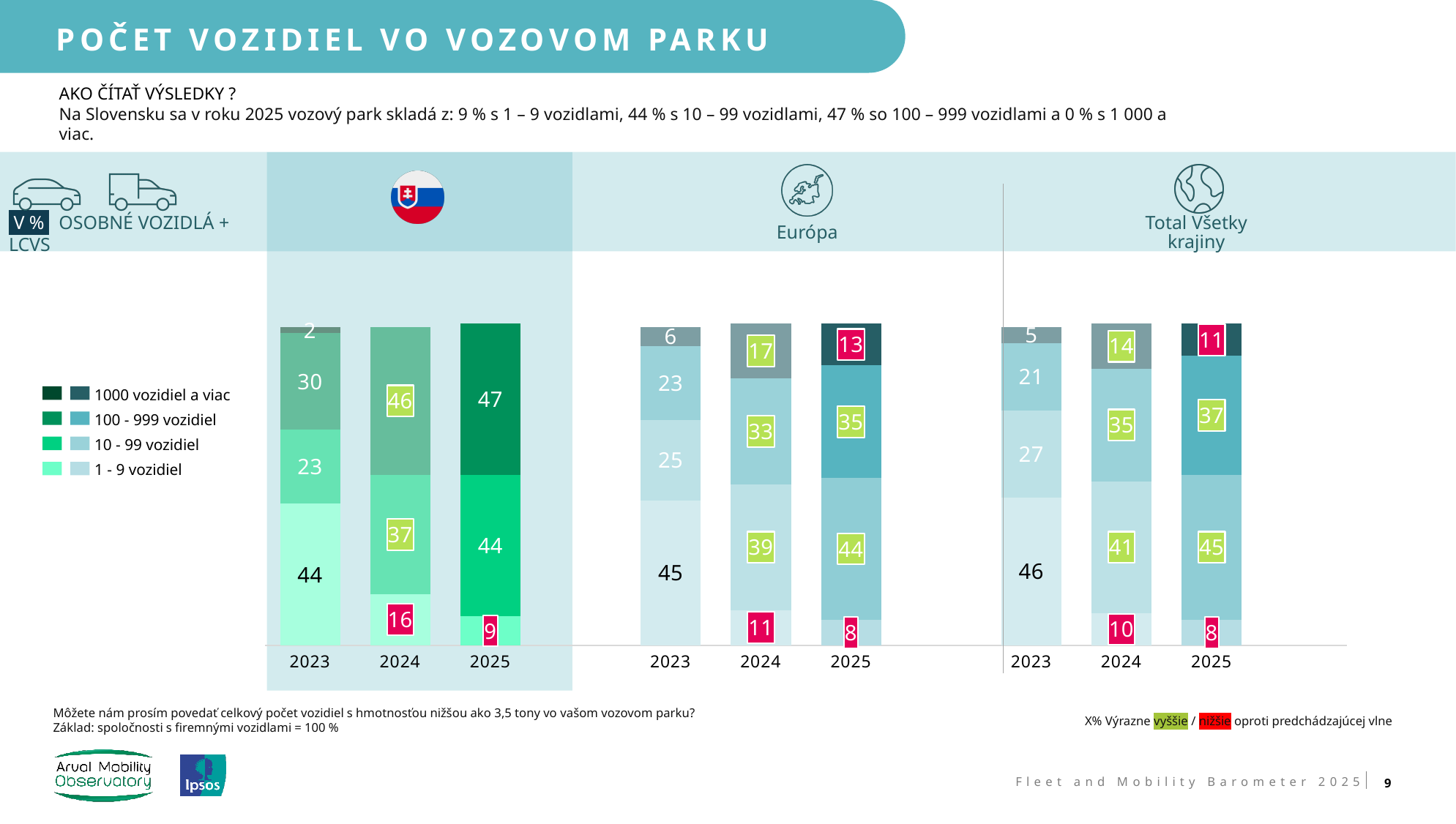
In the Slovakia chart (left), what is the difference between the 1 - 9 vozidiel values for 2023 and 2025? 35 How many years are shown on the x axis of the Európa chart (middle)? 3 In the Európa chart (middle), what is the value for the 1000 vozidiel a viac segment in 2025? 13 How many series does the legend list? 4 What kind of chart is used on this slide? Stacked bar chart In the Total Všetky krajiny chart (right), what is the value for the 10 - 99 vozidiel segment in 2024? 41 In the Slovakia chart (left, with the flag), what is the value for the 100 - 999 vozidiel segment in 2025? 47 In the Európa chart (middle), what is the total of the stacked bar for 2024? 100 In the Slovakia chart (left), which year has the highest value for the 1 - 9 vozidiel segment? 2023 In the Slovakia chart (left), what is the value for the 1 - 9 vozidiel segment in 2023? 44 In the Total Všetky krajiny chart (right), which is larger: the 100 - 999 vozidiel value in 2024 or in 2025? 2025 In the Európa chart (middle), which year has the lowest value for the 1000 vozidiel a viac segment? 2023